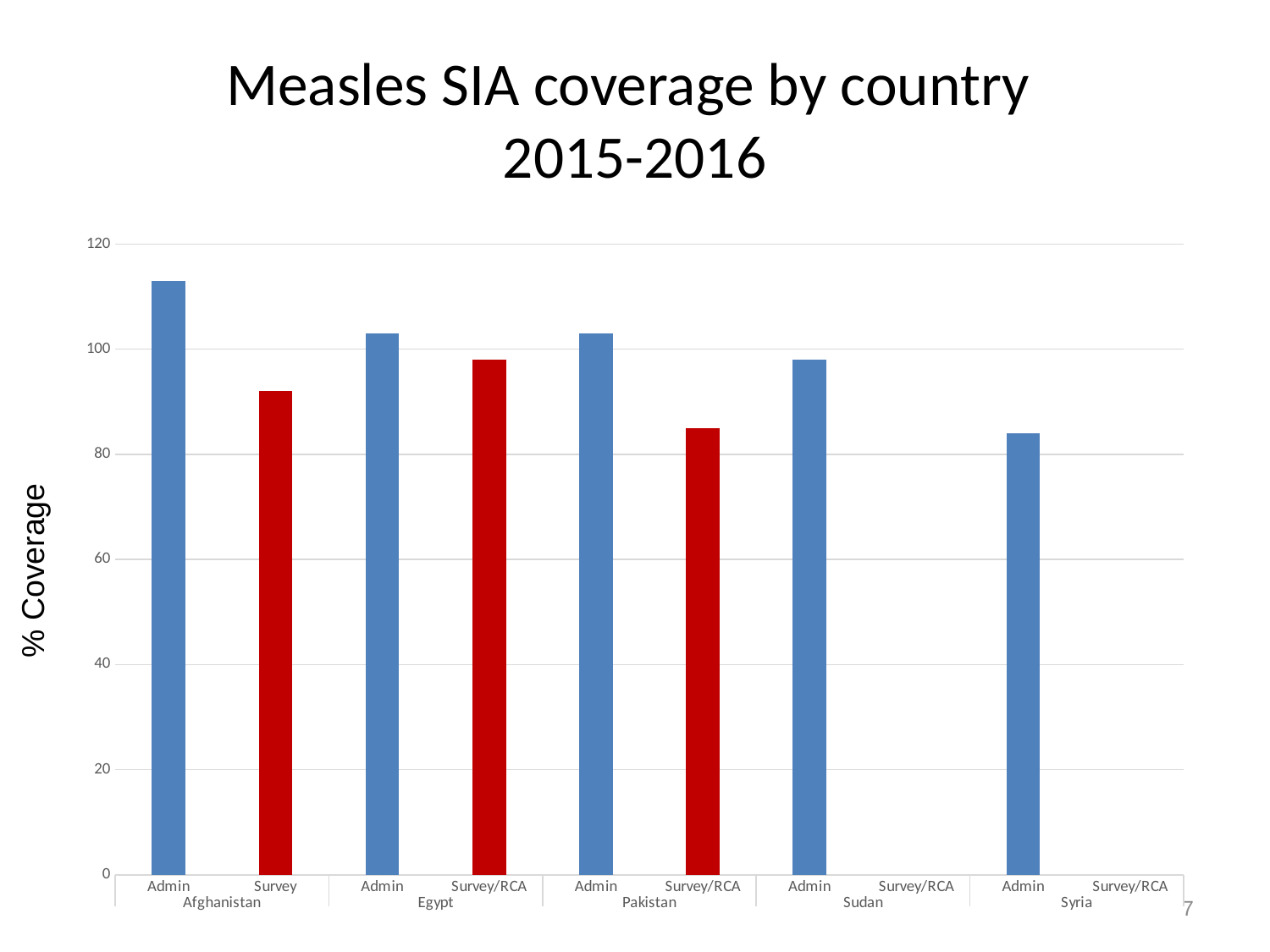
Which is larger, the Admin value for Sudan or the Admin value for Syria? Sudan Which bar has the highest value in the chart? Afghanistan Admin Is the value for Afghanistan Survey greater or less than 100? less How many bars are plotted in the chart? 8 What kind of chart is shown on the slide? bar chart Is the value for Pakistan Survey/RCA greater or less than 80? greater Is the value for Syria Admin greater or less than 100? less What is the label on the vertical axis? % Coverage Which is larger, the Admin value or the Survey/RCA value for Pakistan? Admin How many countries are shown on the x axis? 5 What is the title of the chart? Measles SIA coverage by country 2015-2016